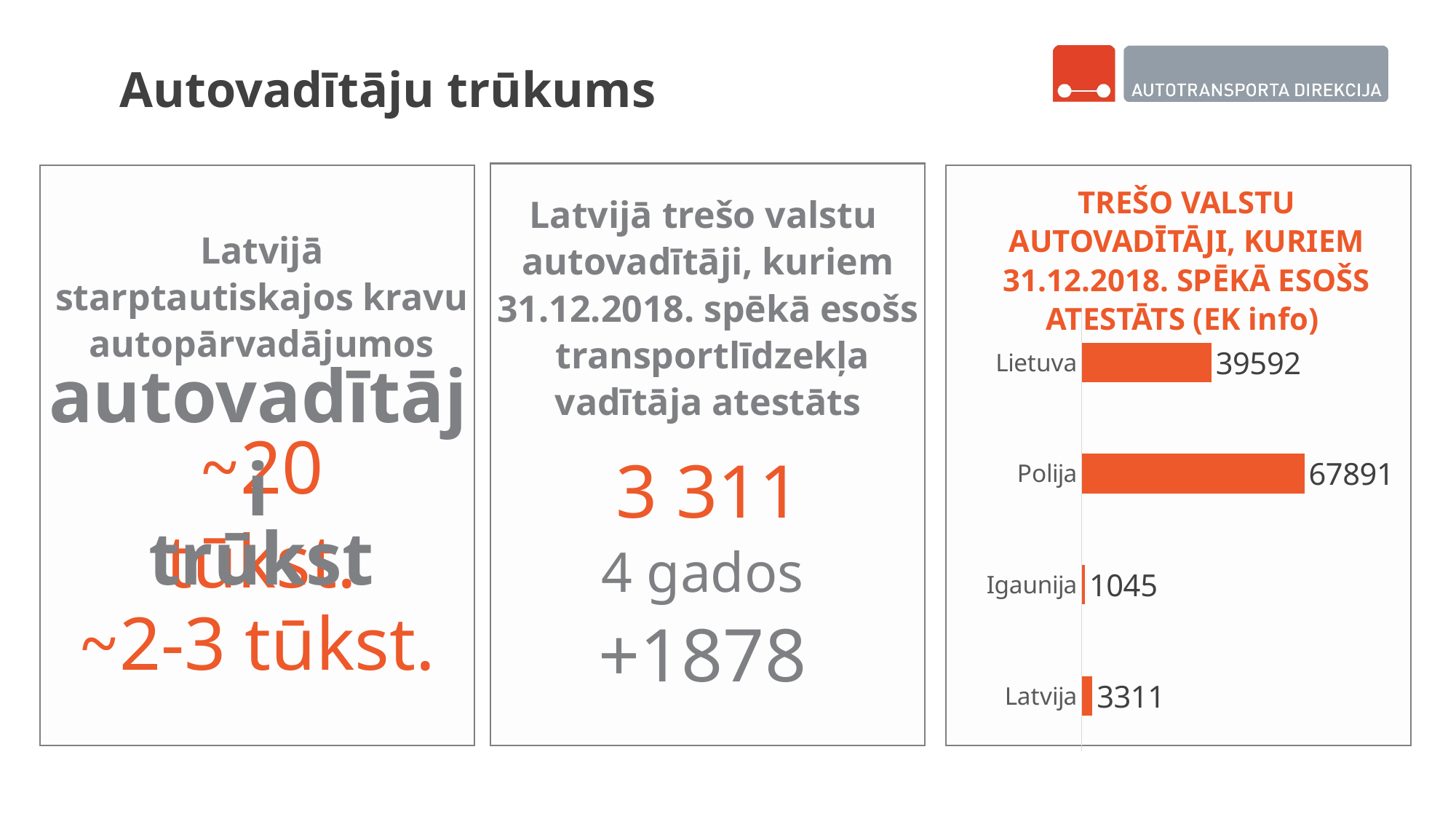
What colour are the bars in the chart? Orange What is the value for Lietuva in the chart? 39592 Which country has the highest value in the chart? Polija How many countries are shown in the chart? 4 What is the value for Polija in the chart? 67891 What is the difference between the values for Polija and Lietuva? 28299 Which has a larger value, Lietuva or Latvija? Lietuva What is the value for Igaunija in the chart? 1045 What type of chart is shown on the slide? Bar chart What is the difference between the values for Latvija and Igaunija? 2266 What is the value for Latvija in the chart? 3311 Which country has the lowest value in the chart? Igaunija